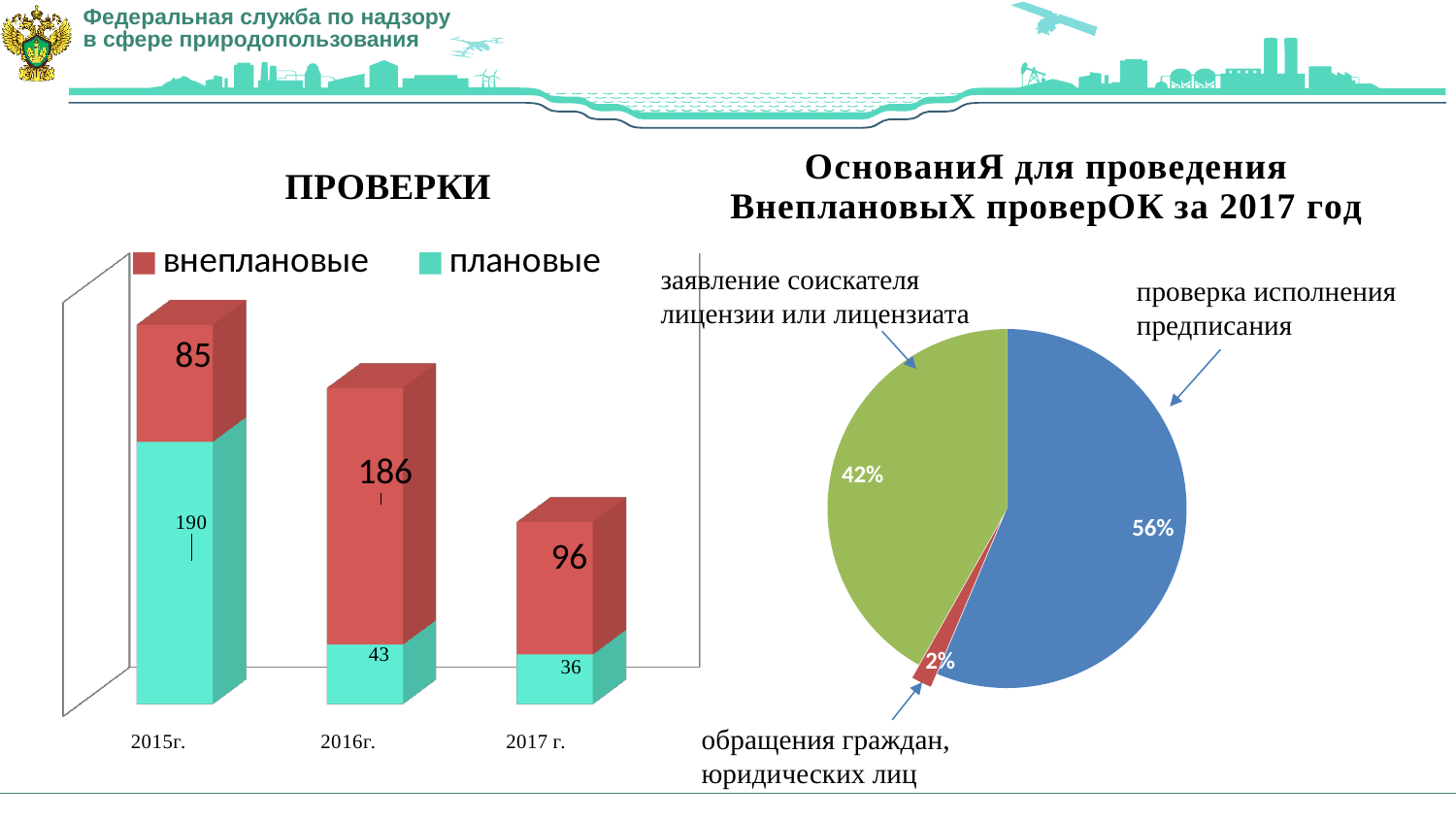
In the pie chart 'Основания для проведения внеплановых проверок за 2017 год', what share is проверка исполнения предписания? 56% In the 'ПРОВЕРКИ' chart, what is the difference between внеплановые in 2016г. and внеплановые in 2017 г.? 90 In the 'ПРОВЕРКИ' chart, what is the value for плановые in 2017 г.? 36 In the 'ПРОВЕРКИ' chart, which year has the lowest value for плановые? 2017 г. What kind of chart is the chart on the right of the slide? pie chart In the 'ПРОВЕРКИ' chart, which year has the highest value for внеплановые? 2016г. In the 'ПРОВЕРКИ' chart, do the плановые values rise or fall from 2015г. to 2017 г.? fall In the 'ПРОВЕРКИ' chart, what is the value for плановые in 2015г.? 190 In the 'ПРОВЕРКИ' chart, what is the total of the stacked bar for 2016г.? 229 In the 'ПРОВЕРКИ' chart, how many series does the legend list? 2 In the 'ПРОВЕРКИ' chart, what is the value for внеплановые in 2016г.? 186 In the pie chart 'Основания для проведения внеплановых проверок за 2017 год', which category has the smallest slice? обращения граждан, юридических лиц